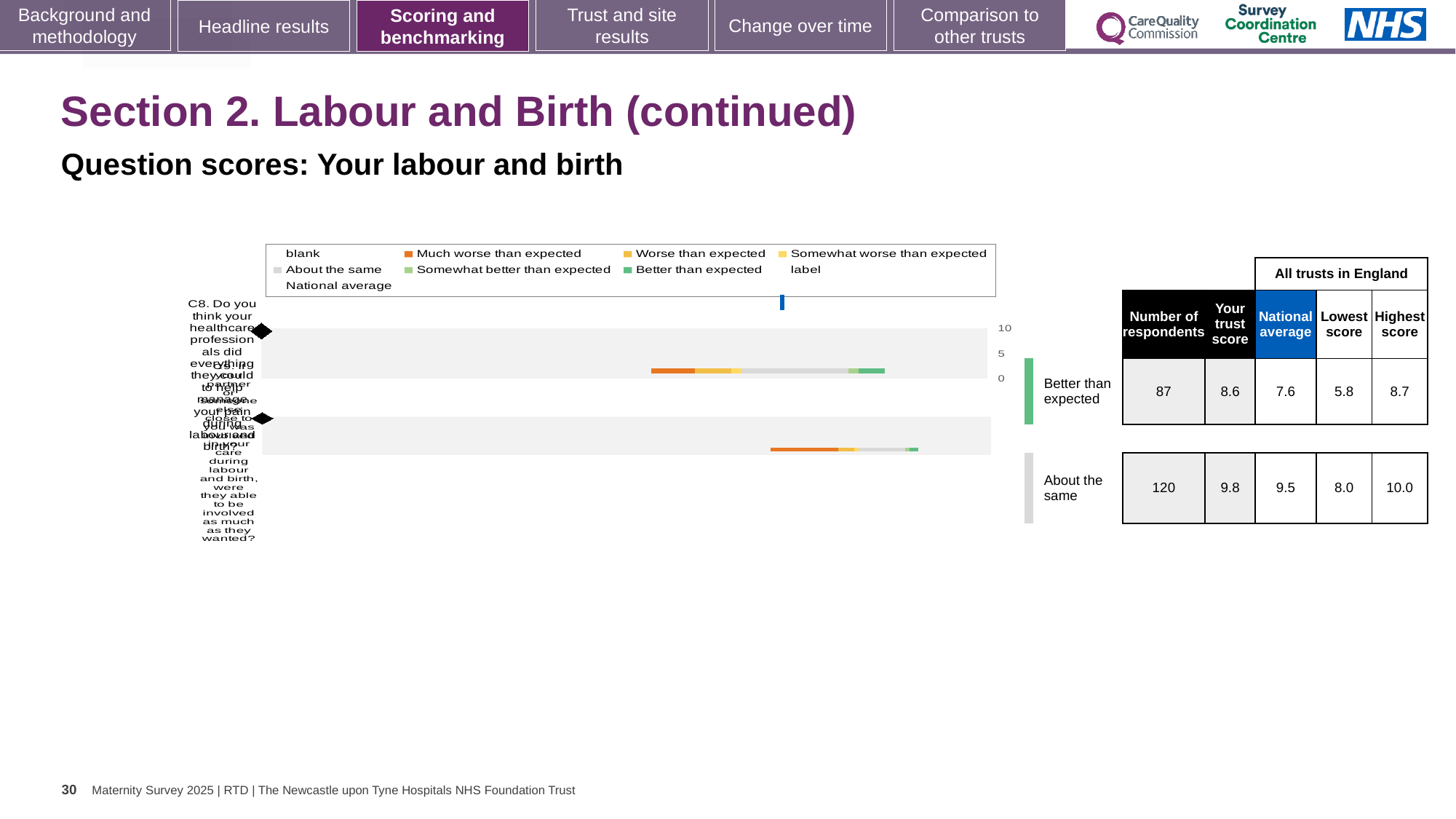
What kind of chart is shown on the slide? Bar chart In the table beside the chart, what is the Highest score for the 'About the same' row? 10.0 In the table beside the chart, what is the National average for the row labelled 'About the same'? 9.5 For the 'Better than expected' row, what is the difference between the trust score and the National average? 1.0 In the table beside the chart, what is the Lowest score for the 'Better than expected' row? 5.8 For the 'Better than expected' row, which is larger: the trust score or the National average? Your trust score In the table beside the chart, how many respondents are listed for the 'Better than expected' row? 87 What colour does the legend use for 'Much worse than expected'? Orange What is the difference in number of respondents between the 'About the same' row and the 'Better than expected' row? 33 How many bars (question rows) are plotted in the chart? 2 In the table beside the chart, what is the 'Your trust score' for the row labelled 'Better than expected'? 8.6 What heading appears above the National average, Lowest score and Highest score columns in the table? All trusts in England